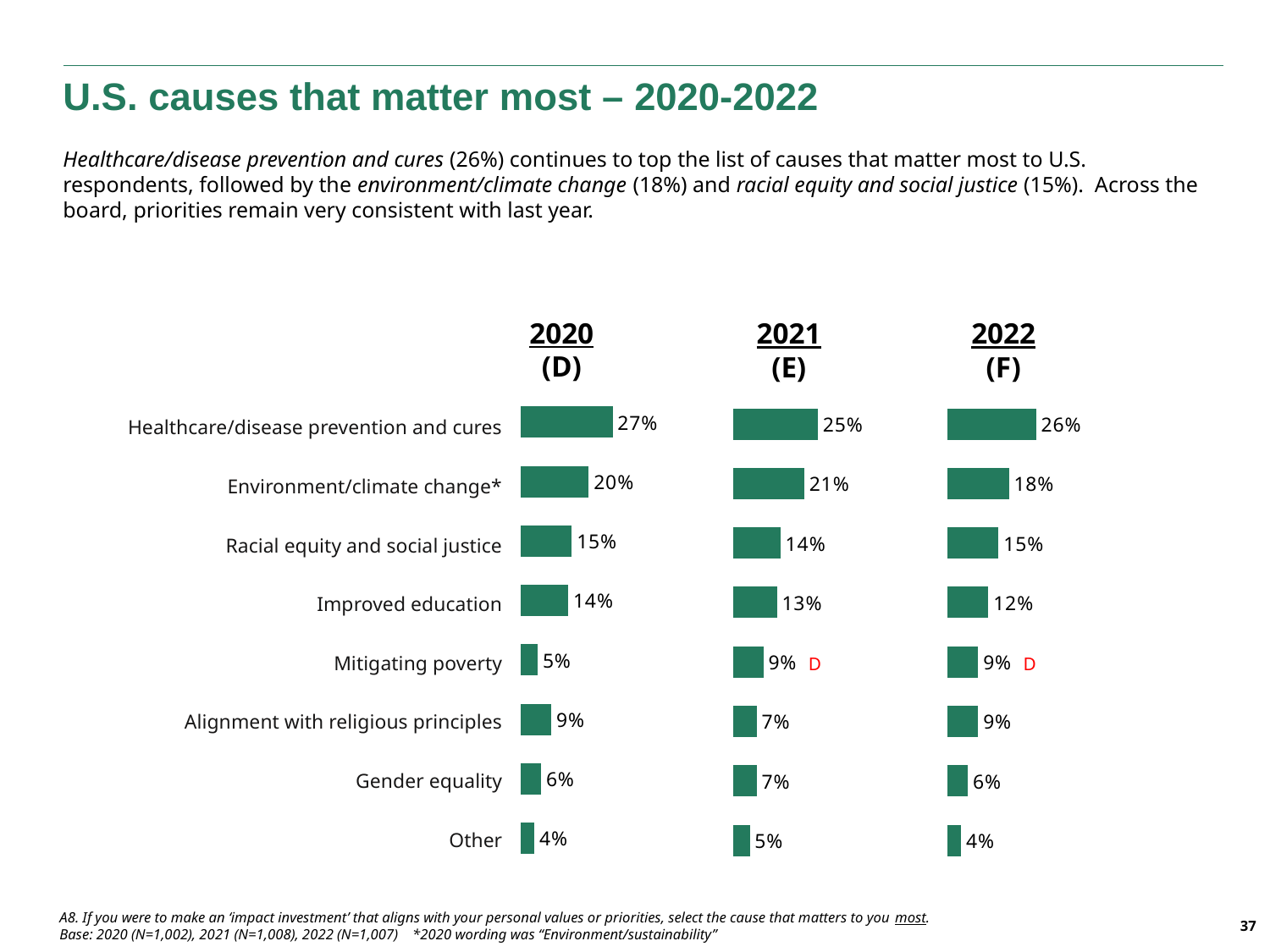
In the 2020 (D) chart, what is the value for Healthcare/disease prevention and cures? 27% In the 2022 (F) chart, which category has the highest value? Healthcare/disease prevention and cures In the 2022 (F) chart, which is larger: Racial equity and social justice or Improved education? Racial equity and social justice What is the title of the slide containing these charts? U.S. causes that matter most – 2020-2022 What kind of chart is used to show the 2020 (D) data? Bar chart In the 2021 (E) chart, what is the value for Mitigating poverty? 9% In the 2021 (E) chart, what is the difference between Healthcare/disease prevention and cures and Environment/climate change*? 4% In the 2022 (F) chart, what is the value for Environment/climate change*? 18% How many categories are shown in the 2022 (F) chart? 8 In the 2020 (D) chart, which category has the lowest value? Other In the 2020 (D) chart, what is the difference between Alignment with religious principles and Mitigating poverty? 4% In the 2021 (E) chart, which is larger: Environment/climate change* or Healthcare/disease prevention and cures? Healthcare/disease prevention and cures